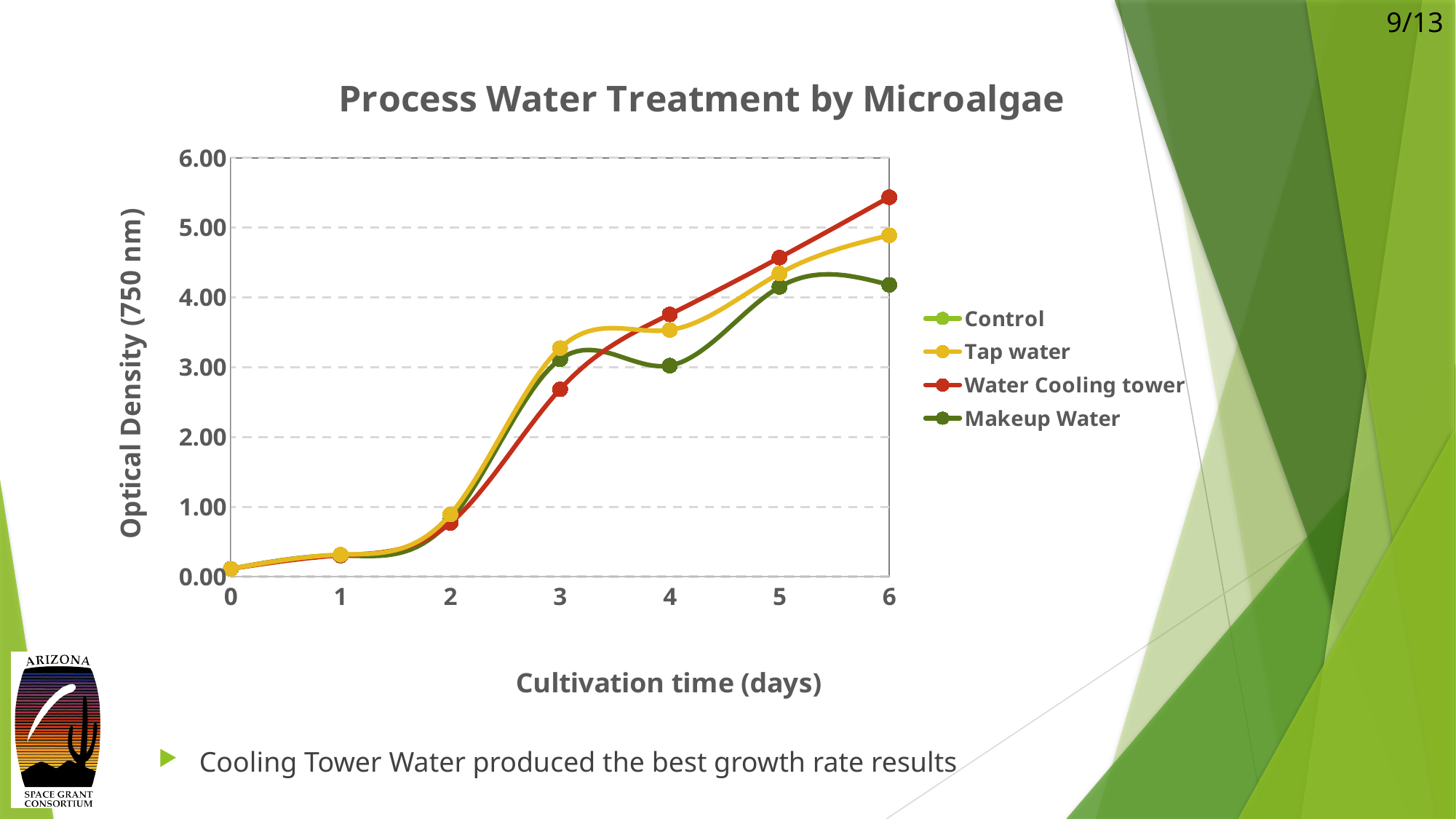
Is the optical density for Water Cooling tower at day 6 greater or less than 5.00? greater What is the title of the chart? Process Water Treatment by Microalgae At day 4, which is larger: the optical density for Tap water or for Makeup Water? Tap water Is the optical density for Water Cooling tower at day 3 greater or less than 3.00? less What kind of chart is shown on the slide? line chart How many series does the chart legend list? 4 Which series has the lowest optical density at day 3? Water Cooling tower What is the label of the y axis? Optical Density (750 nm) How many cultivation time points are plotted along the x axis? 7 Do the optical density values for Water Cooling tower rise or fall from day 0 to day 6? rise Which series has the lowest optical density at day 6? Makeup Water Which series has the highest optical density at day 6? Water Cooling tower